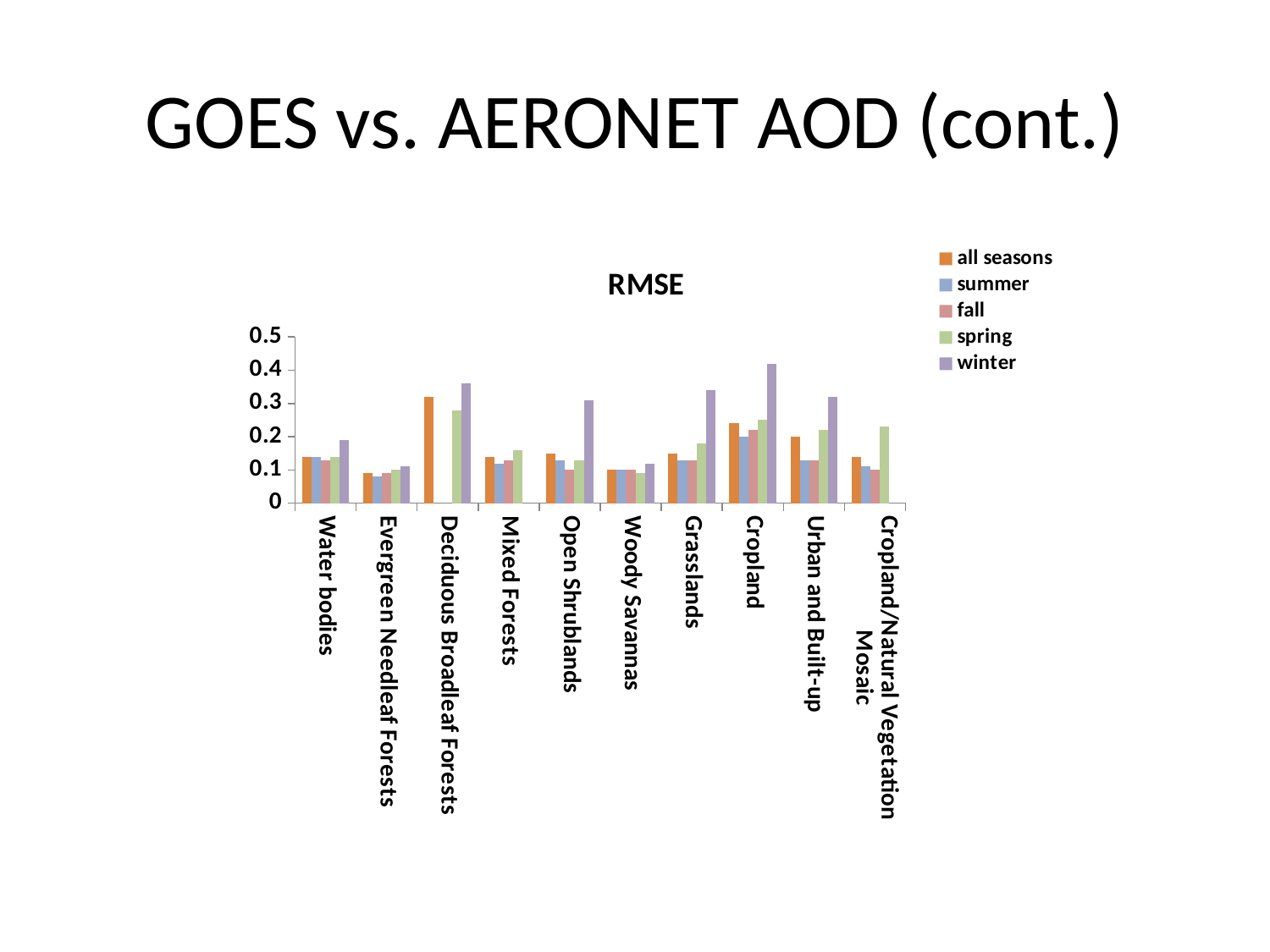
Which series has the highest RMSE for Cropland? winter Is the winter RMSE for Cropland greater or less than 0.3? greater What type of chart is shown on the slide? bar chart Which series are listed in the legend? all seasons, summer, fall, spring, winter What is the title of the chart? RMSE Which category has the highest winter RMSE? Cropland Is the winter RMSE for Woody Savannas greater or less than 0.2? less Is the all seasons RMSE for Deciduous Broadleaf Forests greater or less than 0.2? greater Which series has the highest RMSE for Deciduous Broadleaf Forests? winter How many series does the legend list? 5 Which is larger, the winter RMSE for Cropland or the winter RMSE for Grasslands? Cropland How many land cover categories are shown on the x axis? 10